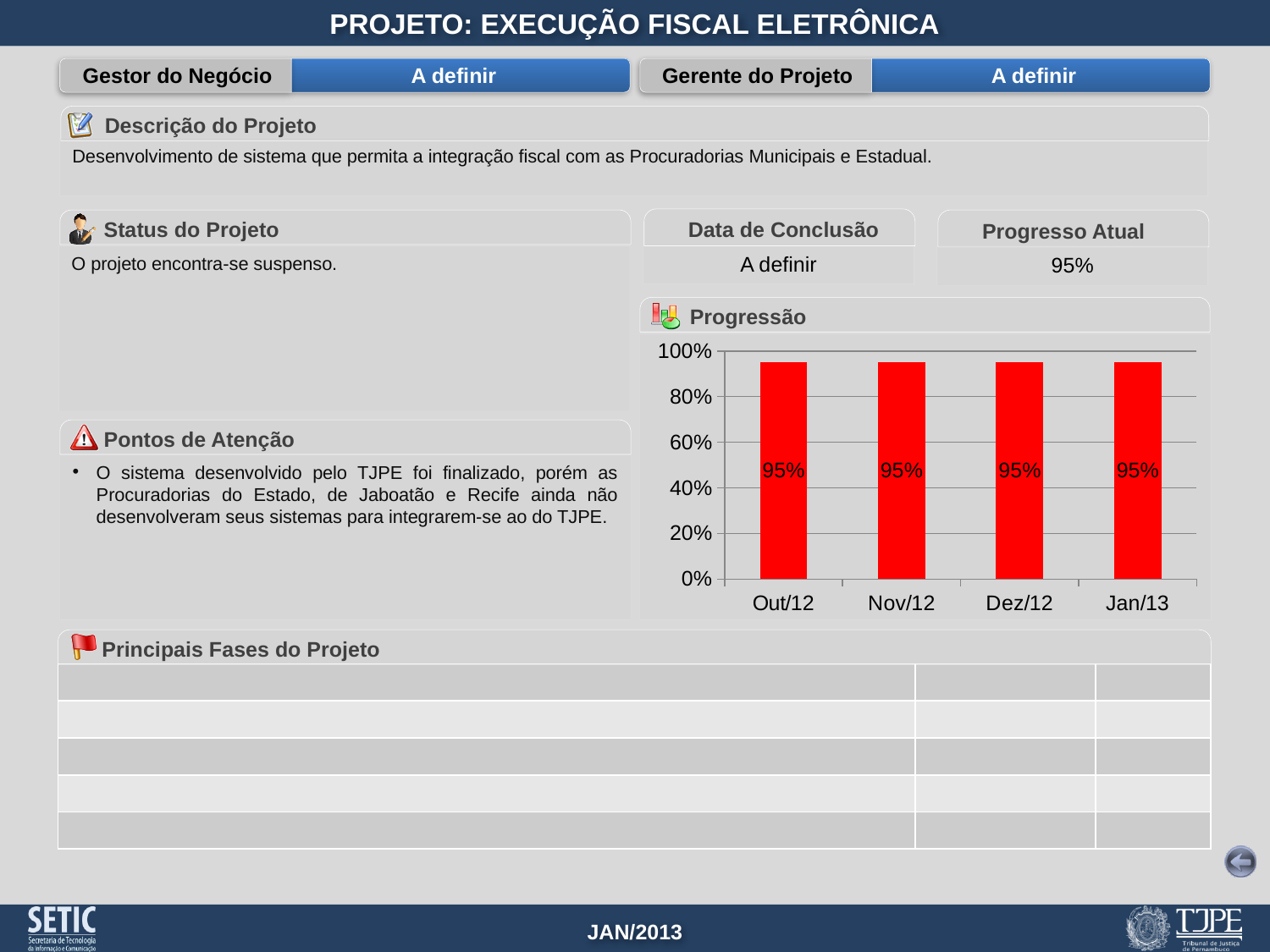
What is the value for Nov/12 in the Progressão chart? 95% Do the values in the Progressão chart rise, fall, or stay flat from Out/12 to Jan/13? stay flat How many categories are shown on the x axis of the Progressão chart? 4 Is the value for Dez/12 in the Progressão chart greater or less than 80%? greater What is the value for Dez/12 in the Progressão chart? 95% What is the title of the chart on the slide? Progressão What is the value for Jan/13 in the Progressão chart? 95% What is the value for Out/12 in the Progressão chart? 95% What colour are the bars in the Progressão chart? red What kind of chart is the Progressão chart? bar chart Is the value for Out/12 in the Progressão chart larger than, smaller than, or the same as the value for Nov/12? the same What is the difference between the values for Jan/13 and Out/12 in the Progressão chart? 0%